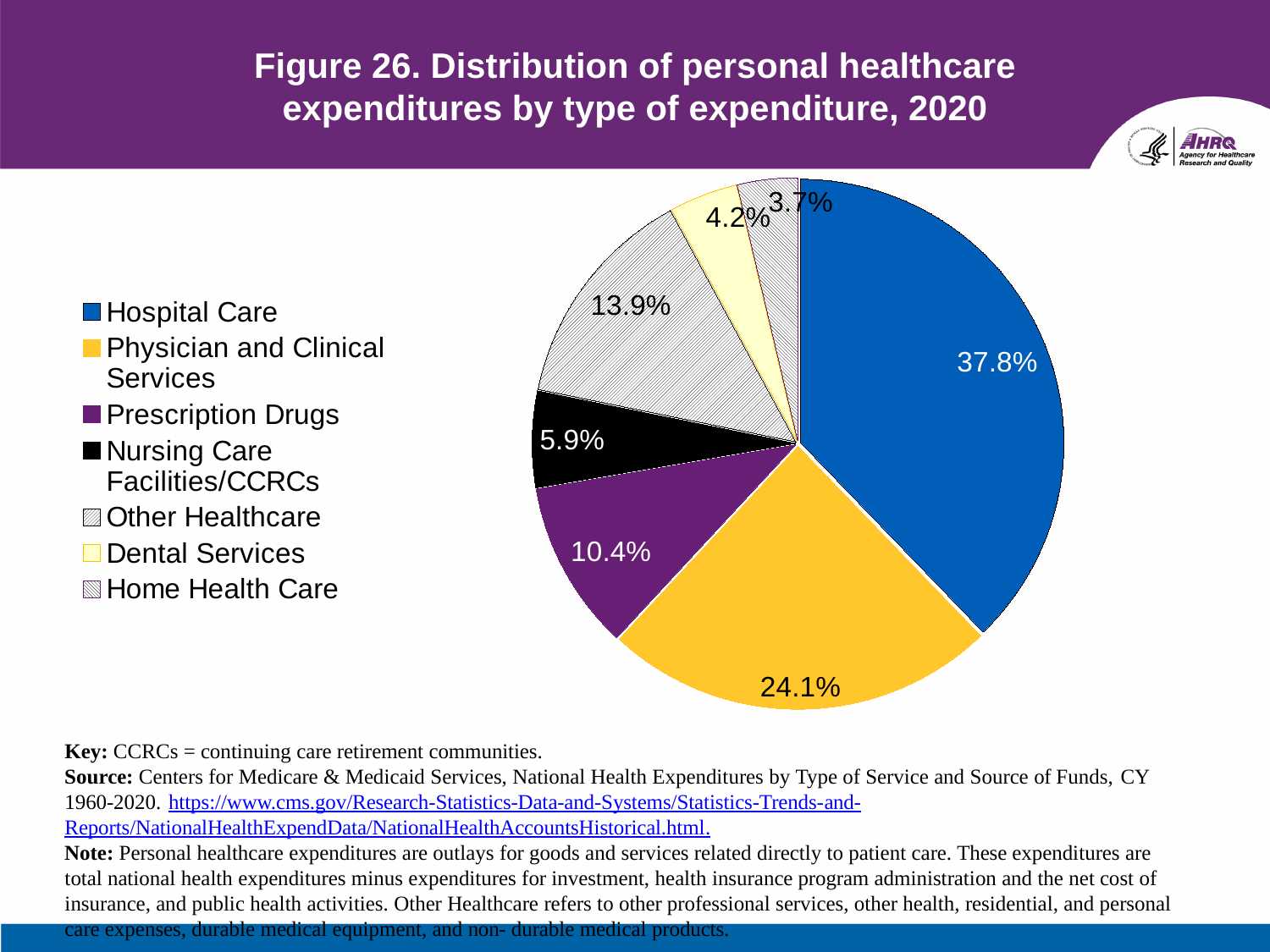
How many percentage points larger is Hospital Care than Physician and Clinical Services? 13.7 What is the title of the chart? Figure 26. Distribution of personal healthcare expenditures by type of expenditure, 2020 What percentage is labeled for Other Healthcare? 13.9% Which type of expenditure has the smallest share of the pie? Home Health Care What kind of chart is shown on the slide? Pie chart What percentage of the pie is Physician and Clinical Services? 24.1% What share is shown for Nursing Care Facilities/CCRCs? 5.9% Which type of expenditure has the largest share of the pie? Hospital Care Which is larger, the share for Other Healthcare or the share for Prescription Drugs? Other Healthcare How many expenditure categories does the pie chart show? 7 What share of personal healthcare expenditures went to Hospital Care in 2020? 37.8% What is the value shown for Prescription Drugs? 10.4%